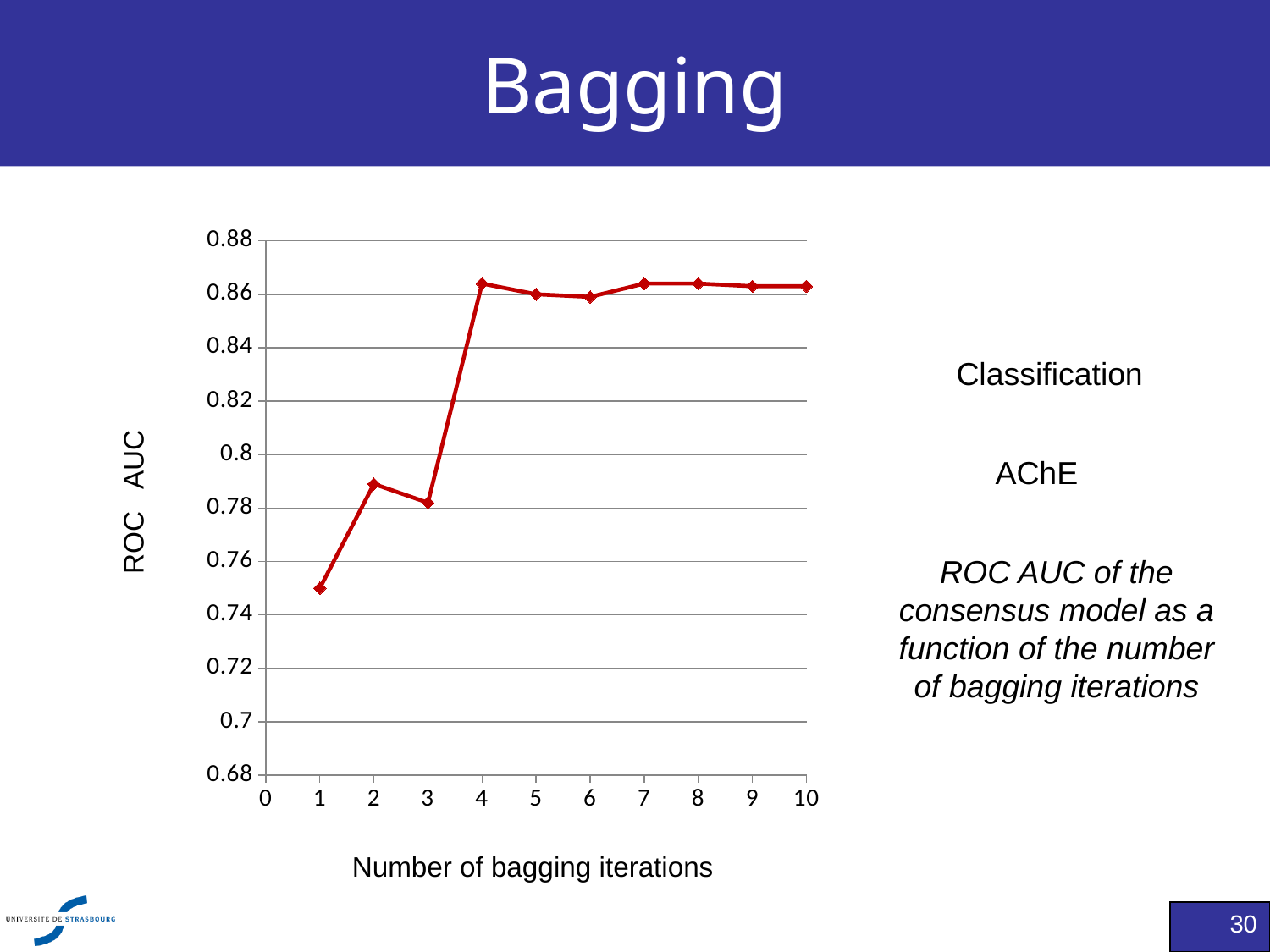
At which number of bagging iterations is the ROC AUC lowest? 1 How many data points are plotted on the line? 10 Is the ROC AUC at 2 bagging iterations greater or less than 0.8? less Is the ROC AUC at 1 bagging iteration greater or less than 0.76? less What is the label of the x axis? Number of bagging iterations Does the ROC AUC generally rise or fall as the number of bagging iterations increases? rise What is the label of the y axis? ROC AUC Is the ROC AUC at 4 bagging iterations greater or less than 0.84? greater What kind of chart is shown on the slide? line chart Which has a higher ROC AUC: 1 bagging iteration or 4 bagging iterations? 4 bagging iterations